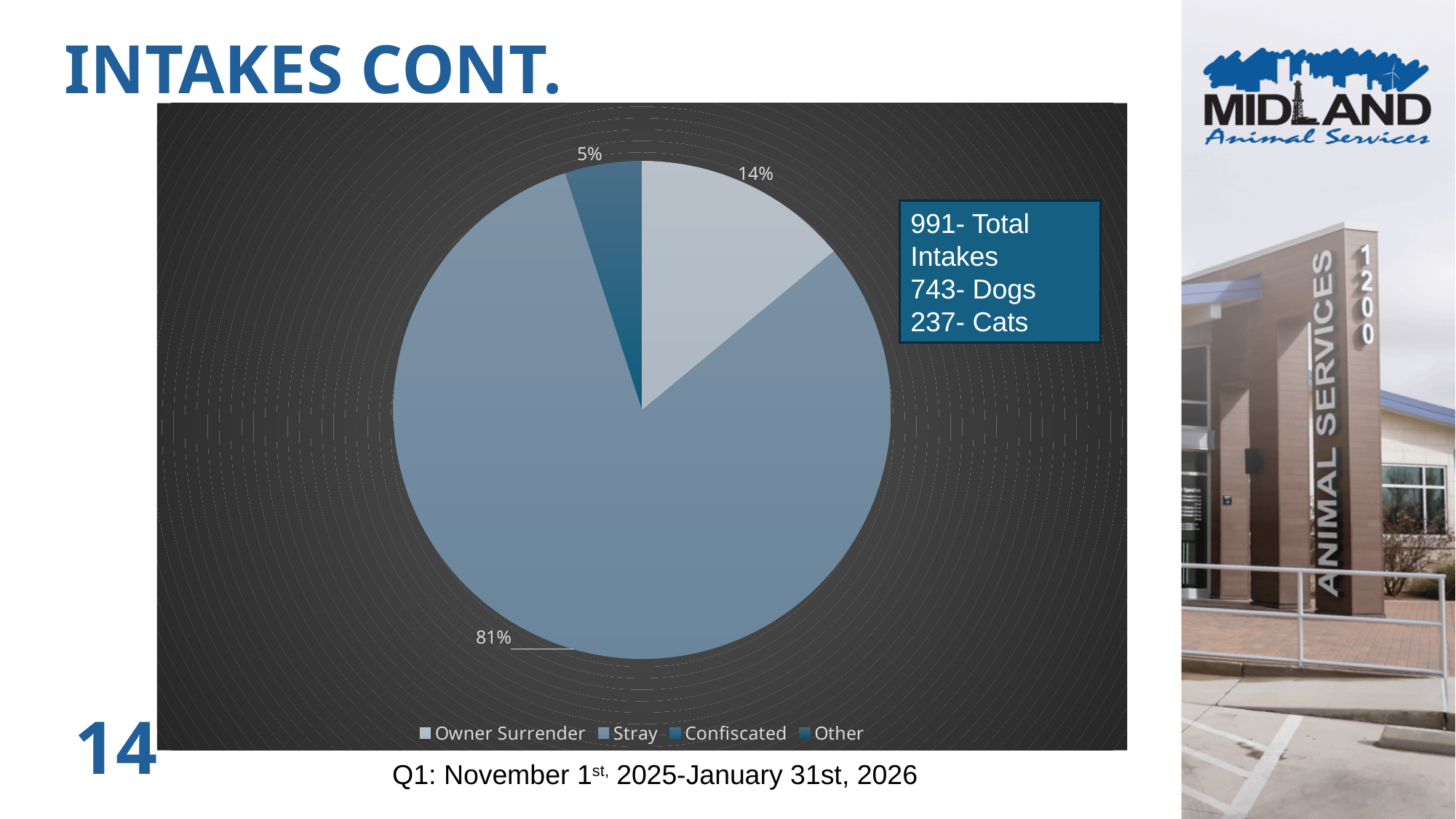
How many categories does the legend list? 4 Of Owner Surrender, Stray and Confiscated, which has the smallest share? Confiscated What share of intakes does the Stray slice represent? 81% Which intake category has the largest slice of the pie? Stray What share of intakes does the Confiscated slice represent? 5% What kind of chart is shown on the slide? pie chart Which is larger, the Owner Surrender share or the Confiscated share? Owner Surrender According to the text box on the chart, how many total intakes were there? 991 What is the title of the slide containing the pie chart? INTAKES CONT. How many percentage points larger is the Owner Surrender share than the Confiscated share? 9 percentage points What share of intakes does the Owner Surrender slice represent? 14% How many percentage points larger is the Stray share than the Owner Surrender share? 67 percentage points